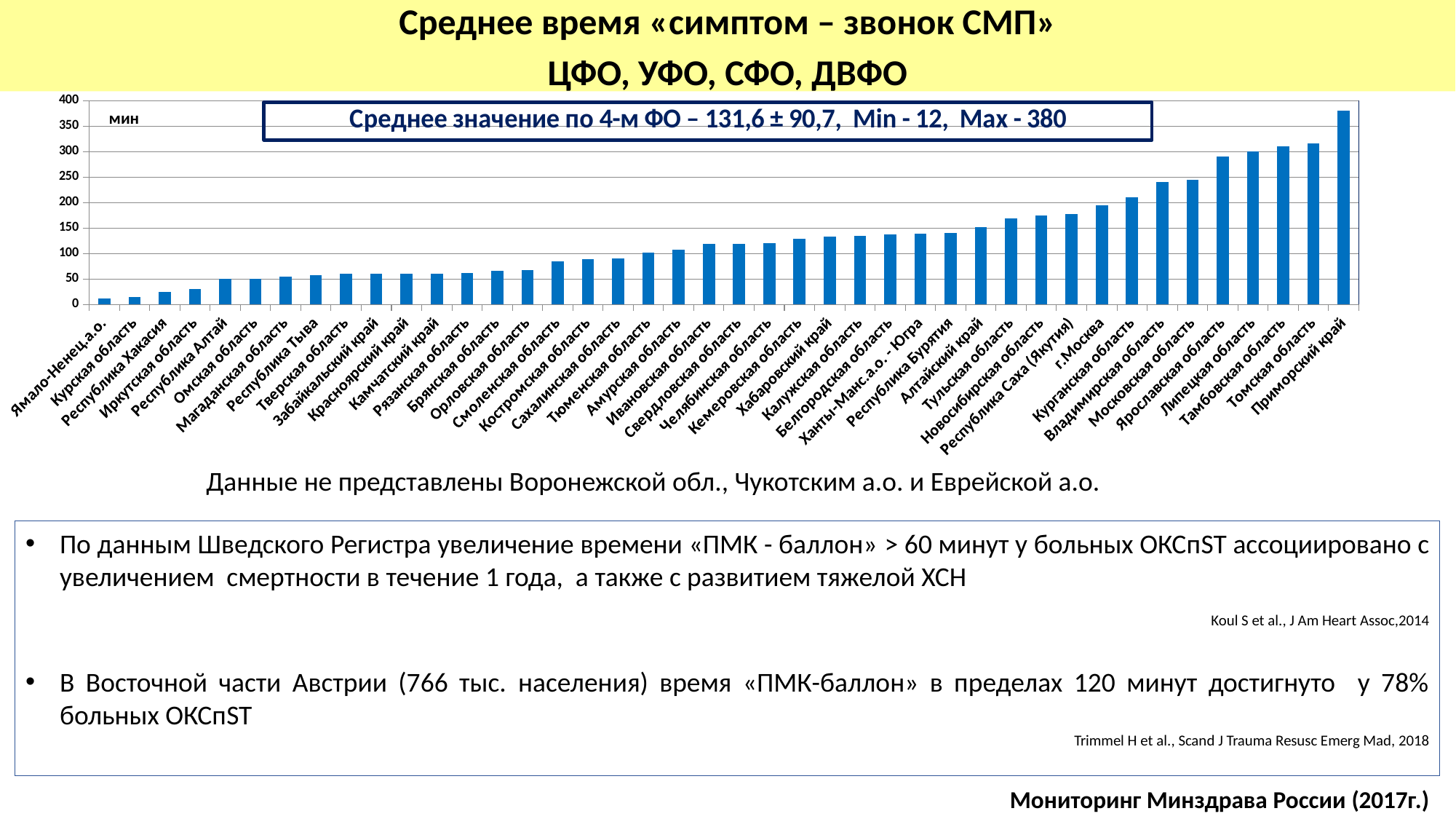
Is the value for Курская область greater or less than 50? less Is the value for Приморский край greater or less than 350? greater Do the bar values rise or fall from left to right along the x axis? rise According to the text box on the chart, what is the mean value across the four federal districts? 131,6 ± 90,7 Which is larger, the value for Московская область or the value for Курганская область? Московская область Which region has the highest average 'symptom – EMS call' time on the chart? Приморский край What unit is shown on the y axis of the chart? мин Which region has the lowest average 'symptom – EMS call' time on the chart? Ямало-Ненец.а.о. According to the text box on the chart, what is the minimum value across the four federal districts? 12 According to the text box on the chart, what is the maximum value across the four federal districts? 380 Is the value for Московская область greater or less than 200? greater What kind of chart is shown on the slide? bar chart